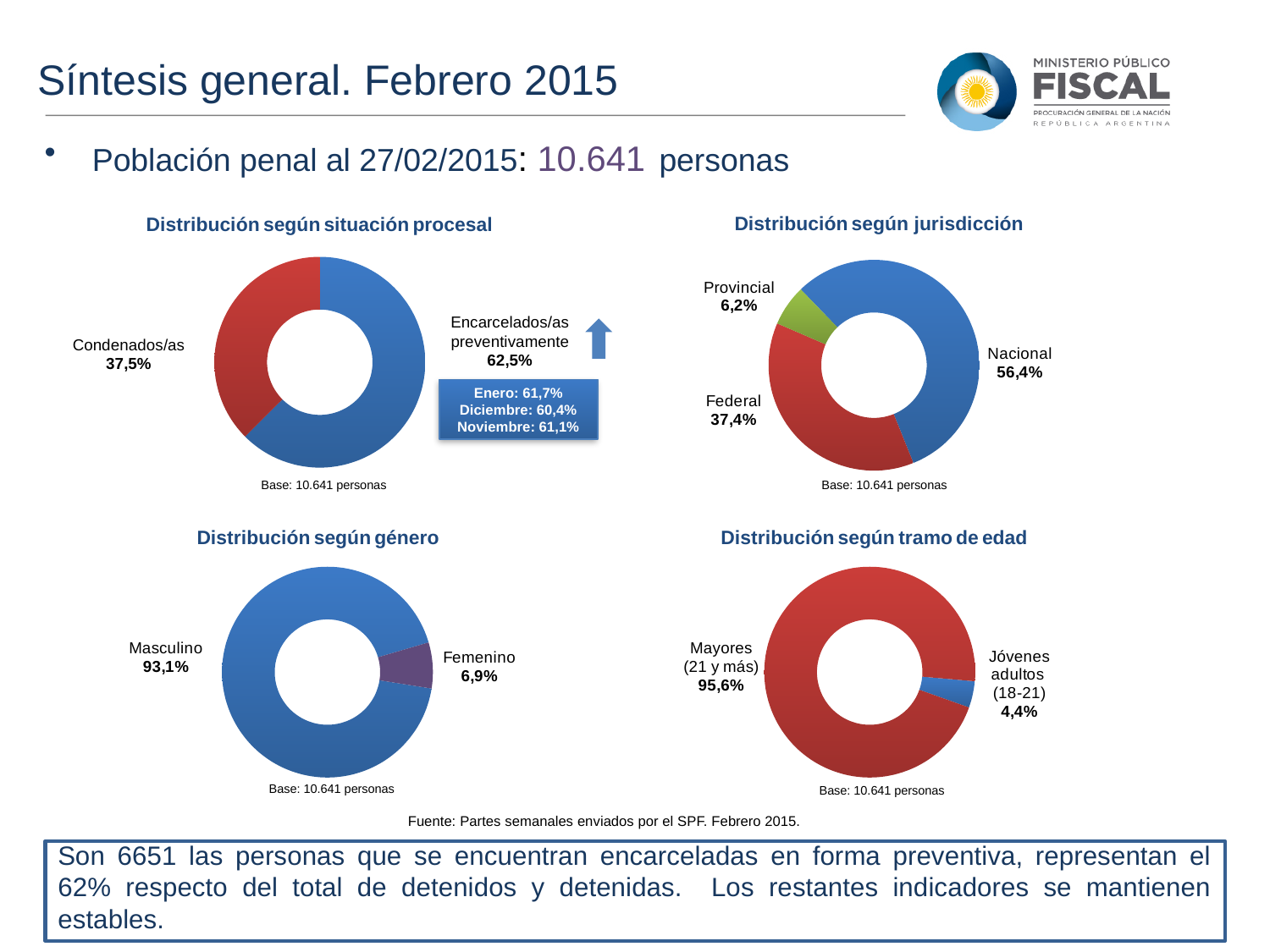
In the 'Distribución según jurisdicción' chart, which category has the smallest share? Provincial In the 'Distribución según jurisdicción' chart, what is the difference between the Nacional and Federal shares? 19,0% In the 'Distribución según situación procesal' chart, what share is Encarcelados/as preventivamente? 62,5% In the 'Distribución según tramo de edad' chart, what is the share of Jóvenes adultos (18-21)? 4,4% In the 'Distribución según tramo de edad' chart, what is the difference between Mayores (21 y más) and Jóvenes adultos (18-21)? 91,2% In the 'Distribución según género' chart, what is the value for Femenino? 6,9% In the 'Distribución según jurisdicción' chart, what is the value for Federal? 37,4% In the 'Distribución según género' chart, which is larger, Masculino or Femenino? Masculino What kind of chart is used for 'Distribución según género'? Pie chart (donut) In the 'Distribución según situación procesal' chart, what share of the population is Condenados/as? 37,5% In the 'Distribución según jurisdicción' chart, how many categories are shown? 3 In the 'Distribución según jurisdicción' chart, which category has the largest share? Nacional